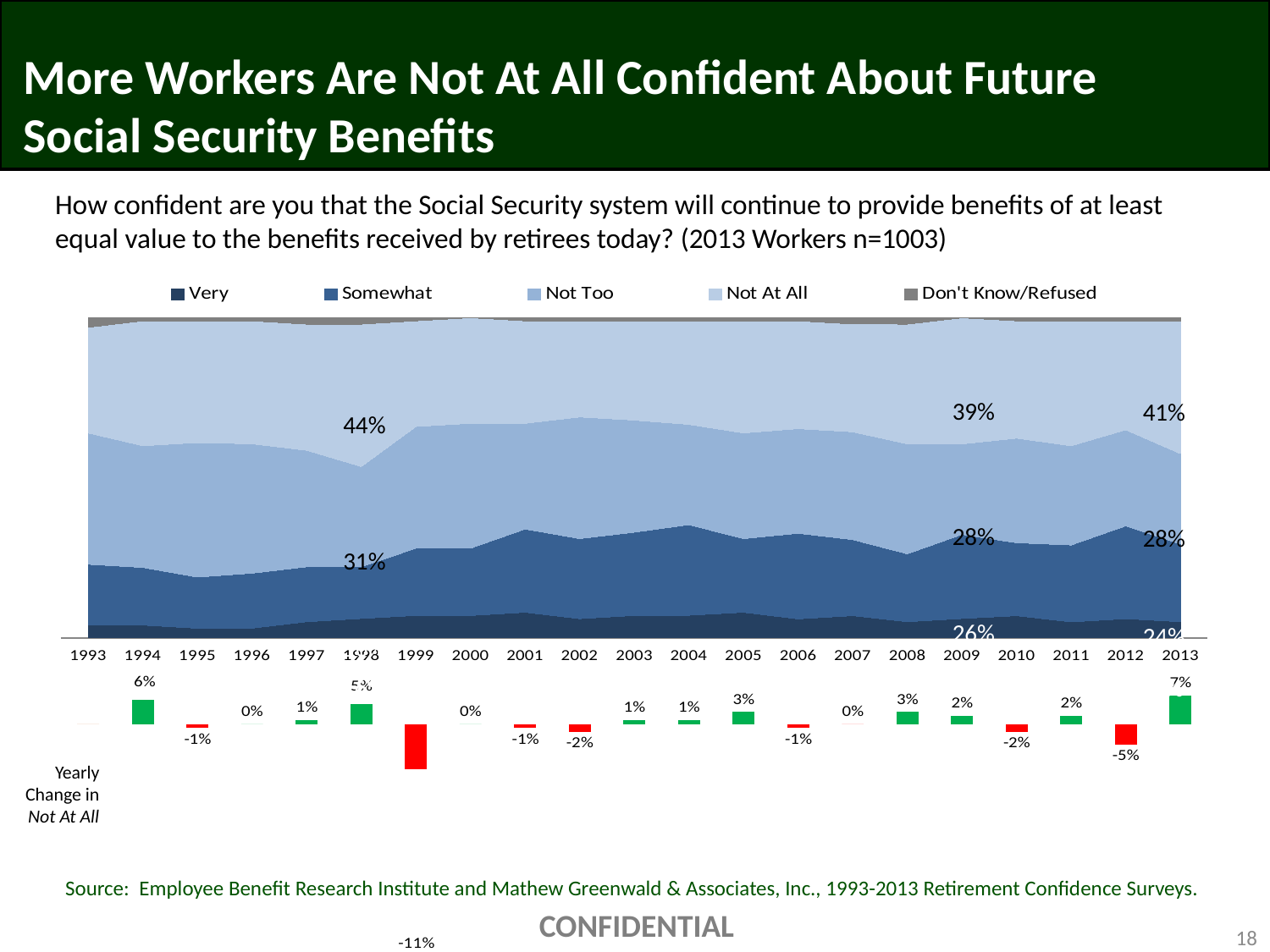
In the lower bar chart, which year has the larger yearly change in Not At All, 1994 or 2008? 1994 In the stacked area chart, what is the Not Too value for 2009? 28% In the lower bar chart, what is the yearly change in Not At All for 2012? -5% What kind of chart is the lower chart showing the yearly change in Not At All? Bar chart In the lower bar chart, which year has the largest yearly change in Not At All? 2013 In the stacked area chart, what is the difference between the Not At All values for 2013 and 2009? 2 percentage points In the stacked area chart, what is the Not At All value for 2013? 41% In the stacked area chart, what is the Not At All value for 1998? 44% In the lower bar chart, which year has the lowest yearly change in Not At All? 1999 In the lower bar chart, what is the yearly change in Not At All for 2013? 7% How many series does the legend of the stacked area chart list? 5 How many years are shown on the x axis of the stacked area chart? 21